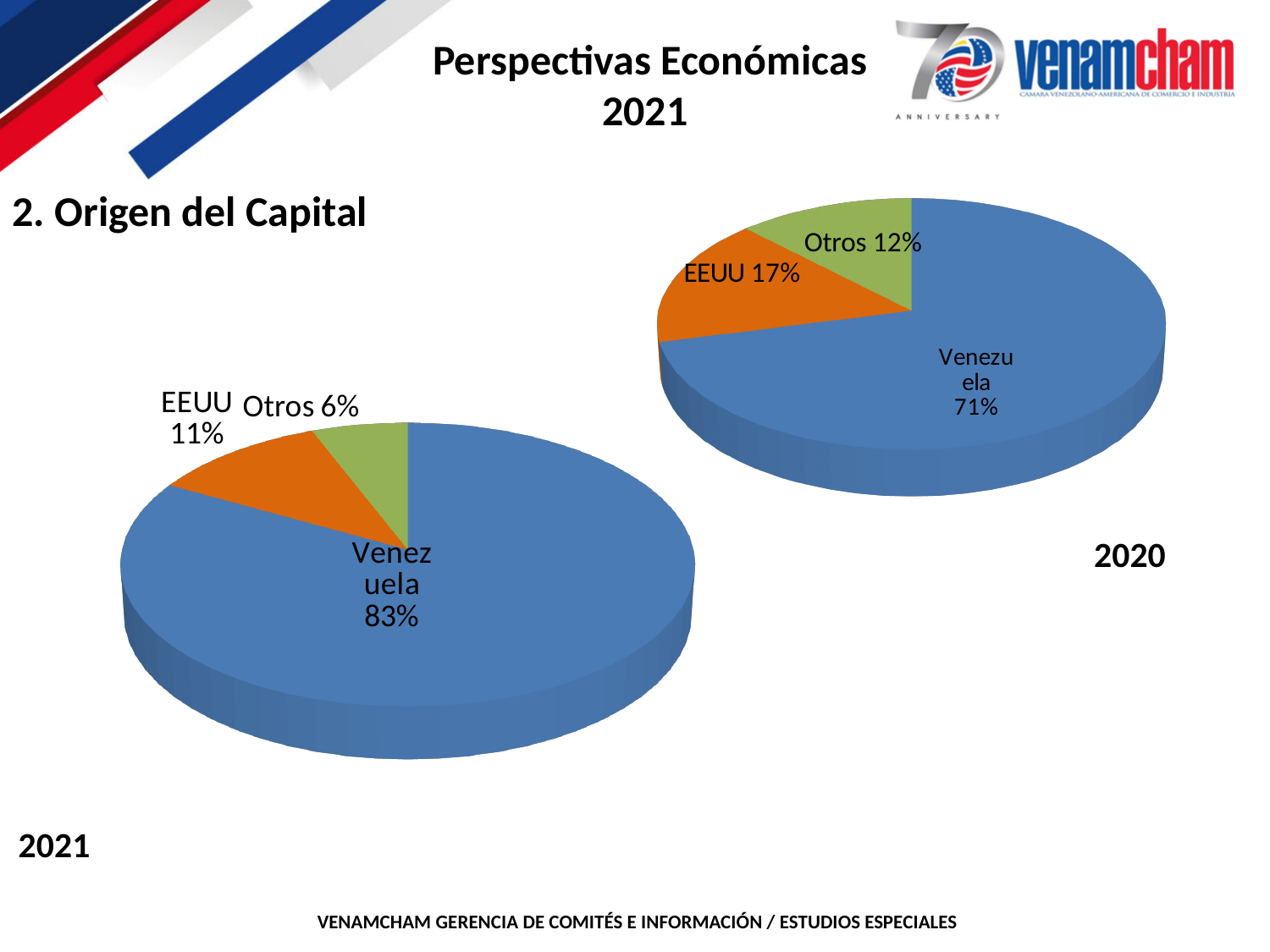
In the 2020 pie chart (top right), what share does EEUU have? 17% How many slices does the 2021 pie chart (bottom left) have? 3 In the 2020 pie chart (top right), what is the difference between the EEUU and Otros shares? 5% In the 2020 pie chart (top right), what share does Otros have? 12% What is the difference between Venezuela's share in the 2021 chart and in the 2020 chart? 12% What colour is the Venezuela slice in both pie charts? Blue In the 2021 pie chart (bottom left), what share does EEUU have? 11% In the 2021 pie chart (bottom left), which category has the largest slice? Venezuela In the 2020 pie chart (top right), which category has the smallest slice? Otros What type of chart is used to show the origin of capital on this slide? Pie chart Is the EEUU share larger in the 2020 chart or the 2021 chart? 2020 In the 2021 pie chart (bottom left), what share does Venezuela have? 83%